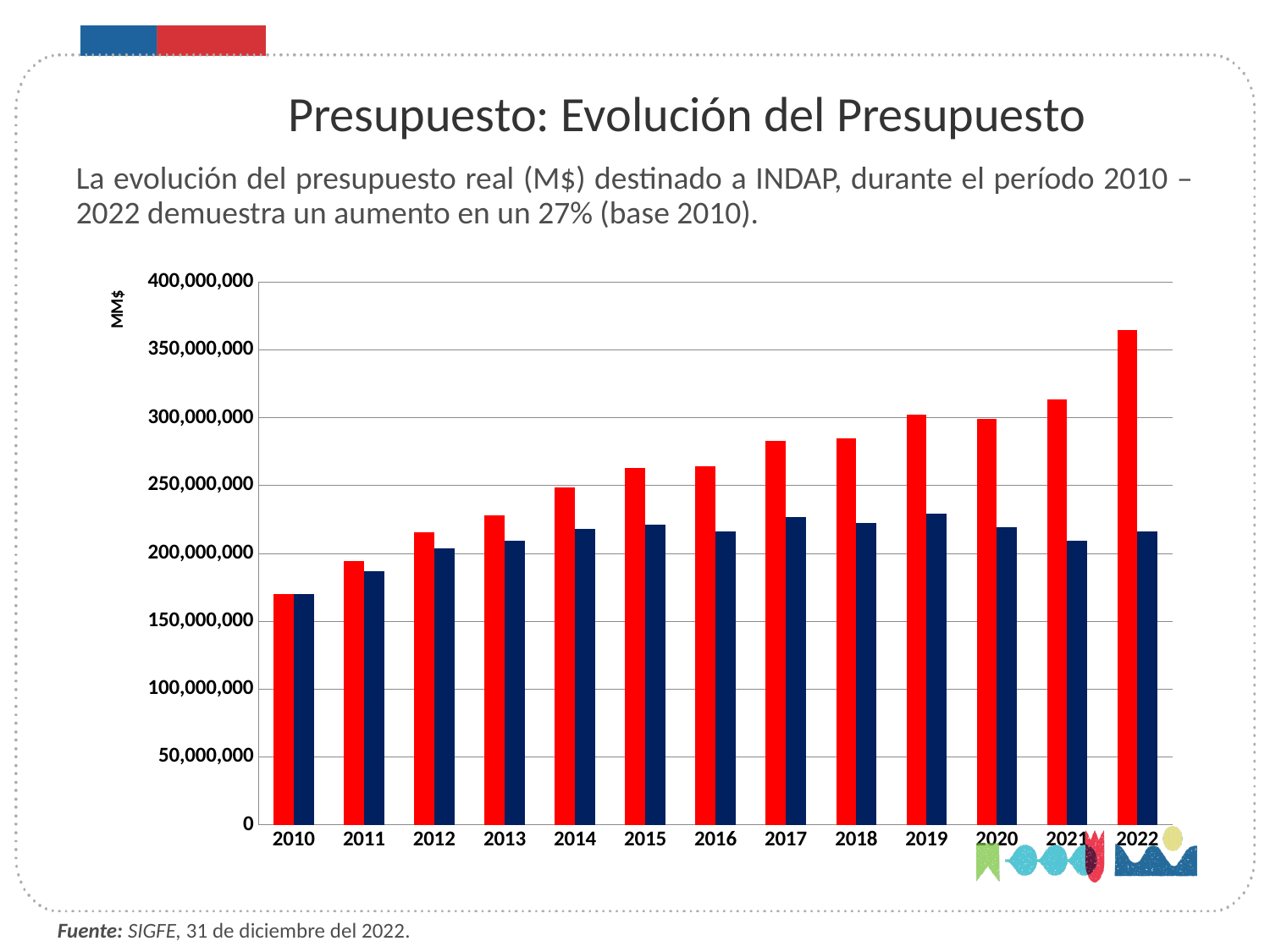
Which is larger, the red bar for 2022 or the red bar for 2010? the red bar for 2022 Is the red bar for 2021 greater or less than 300,000,000? greater Do the red bars generally rise or fall from 2010 to 2022? rise Is the red bar for 2022 greater or less than 350,000,000? greater Is the red bar for 2010 greater or less than 200,000,000? less How many years are shown on the x axis of the chart? 13 What kind of chart is shown on the slide? bar chart In which year is the red bar the tallest? 2022 What label is shown on the vertical axis of the chart? MM$ In which year is the red bar the shortest? 2010